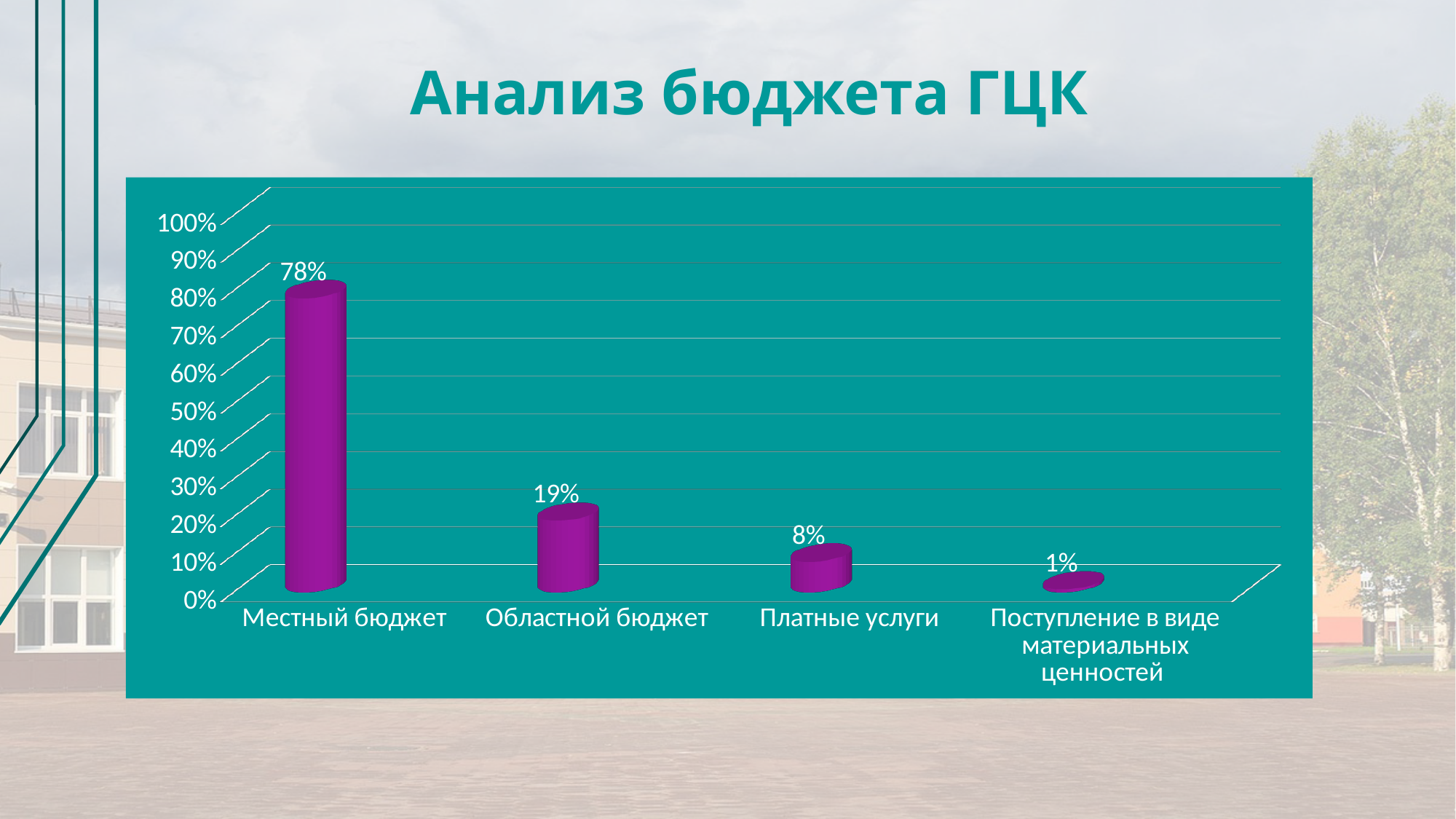
What kind of chart is shown on the slide? Bar chart What is the value for Поступление в виде материальных ценностей? 1% Which is larger, the value for Платные услуги or the value for Поступление в виде материальных ценностей? Платные услуги What is the title of the slide? Анализ бюджета ГЦК Which category has the highest value? Местный бюджет What is the value for Областной бюджет? 19% What is the difference between the values for Областной бюджет and Платные услуги? 11% What is the value for Платные услуги? 8% How many categories are shown on the chart? 4 What is the value for Местный бюджет? 78% What is the difference between the values for Местный бюджет and Областной бюджет? 59% Which category has the lowest value? Поступление в виде материальных ценностей